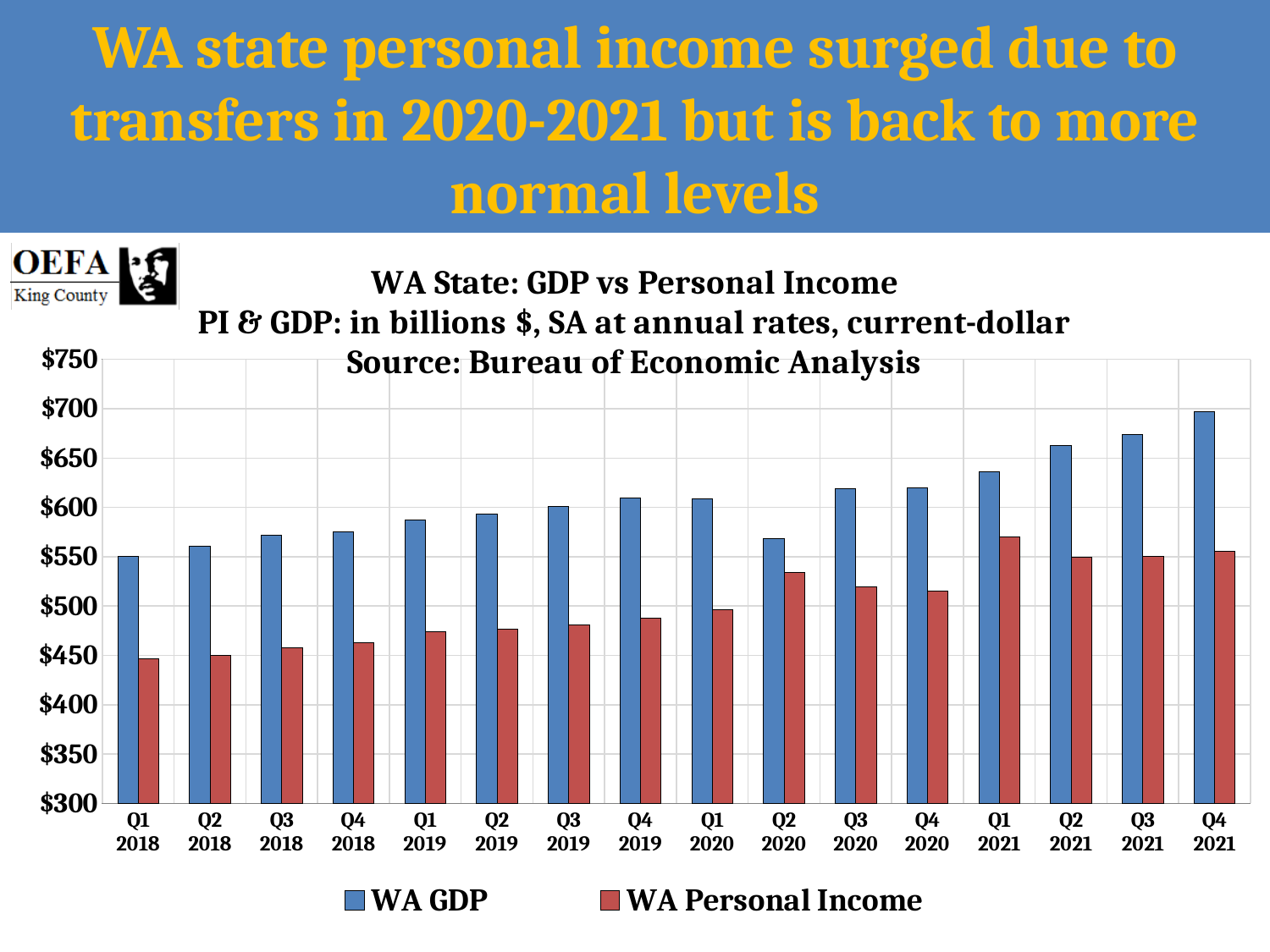
In which quarter is WA GDP lowest? Q1 2018 How many series does the legend list? 2 What kind of chart is shown on the slide? Bar chart In which quarter is WA GDP highest? Q4 2021 In which quarter is WA Personal Income highest? Q1 2021 Is the value for WA Personal Income in Q1 2018 greater or less than $500? less In Q1 2021, which is larger: WA GDP or WA Personal Income? WA GDP Does WA GDP generally rise or fall from Q1 2018 to Q4 2021? rise Is the value for WA Personal Income in Q1 2021 greater or less than $550? greater How many quarters are shown on the x axis? 16 In which quarter is WA Personal Income lowest? Q1 2018 Is the value for WA GDP in Q4 2021 greater or less than $650? greater